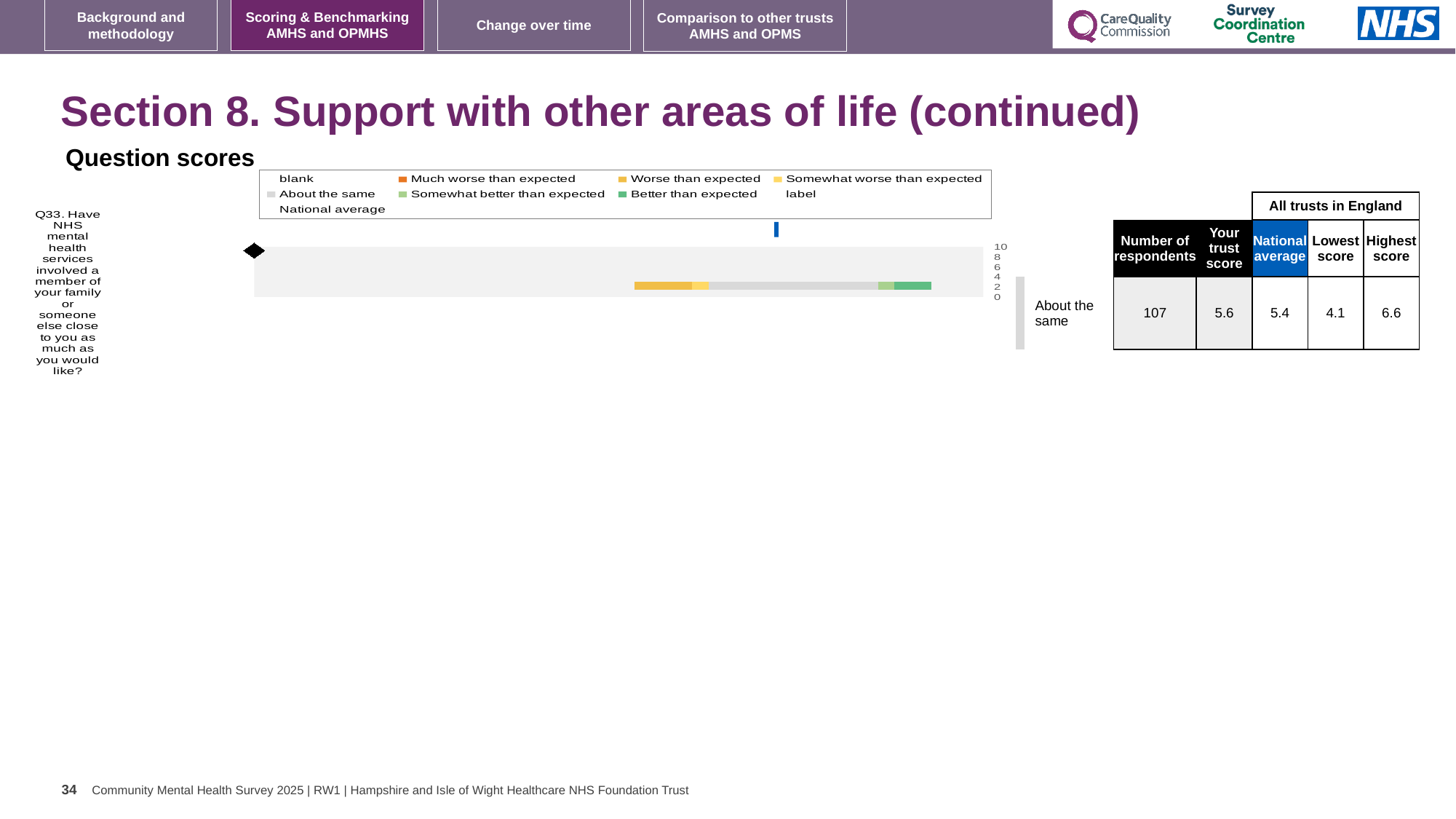
In the table next to the chart, what is the National average for Q33? 5.4 Which question number is plotted in the 'Question scores' chart? Q33 In the table next to the chart, how many respondents answered Q33? 107 According to the label beside the chart, how does the trust's score for Q33 compare with what is expected? About the same What kind of chart is shown under 'Question scores'? bar chart In the table next to the chart, what is the Highest score among all trusts in England for Q33? 6.6 What is the highest tick value shown on the chart's axis? 10 In the table next to the chart, what is the Lowest score among all trusts in England for Q33? 4.1 What is the difference between the Highest score and the Lowest score for Q33 in the table? 2.5 Which is larger for Q33, the trust score or the National average? trust score In the table next to the chart, what is the 'Your trust score' for Q33? 5.6 How many survey questions are plotted in the 'Question scores' chart? 1